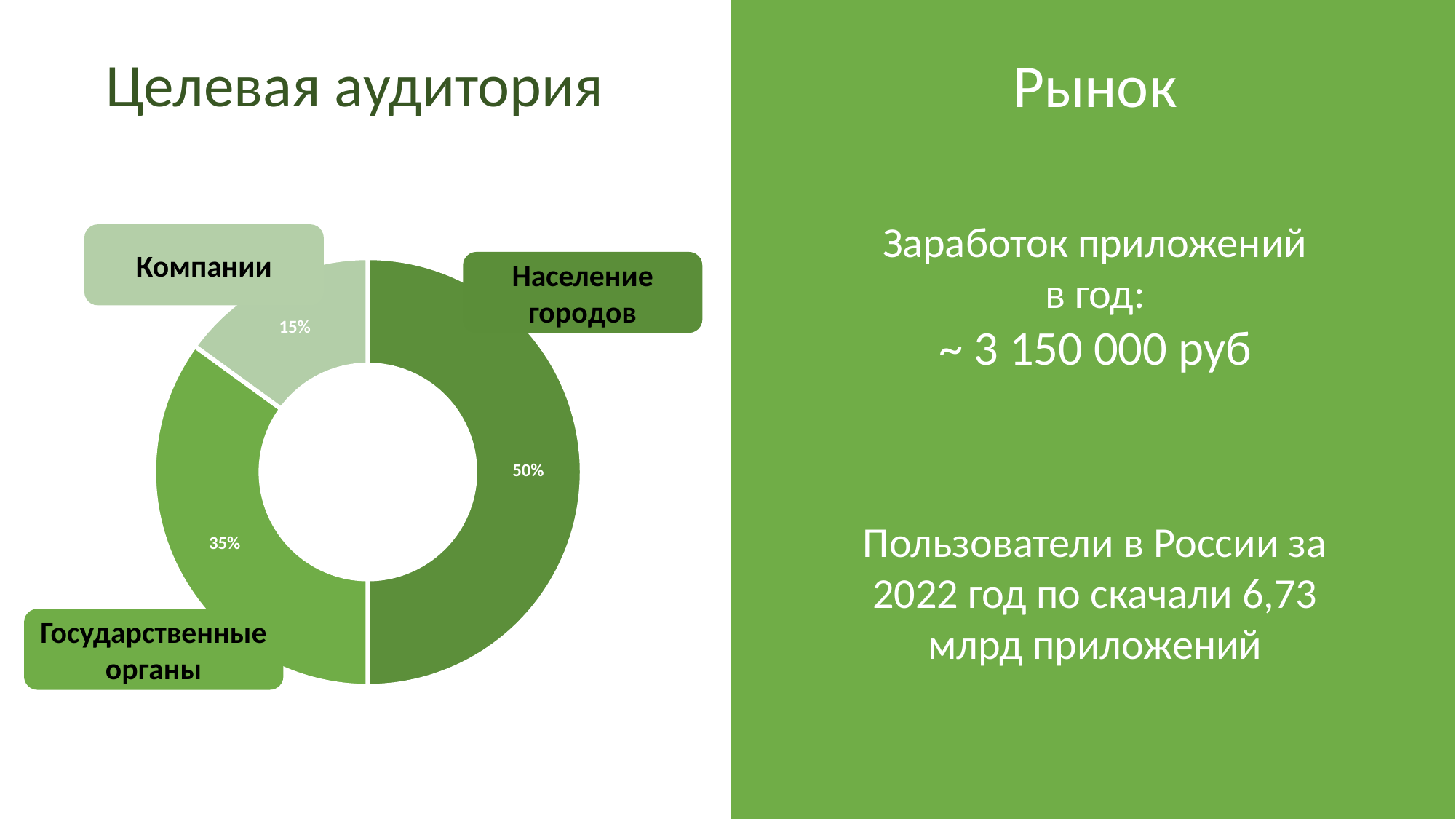
What share of the target audience is Компании? 15% Which is larger: the share for Государственные органы or the share for Компании? Государственные органы What kind of chart is shown on the slide? Doughnut chart What is the difference in percentage points between Государственные органы and Компании? 20 What share of the target audience is Государственные органы? 35% What share of the target audience is Население городов? 50% What is the title above the chart? Целевая аудитория Which category has the smallest share in the chart? Компании Which category is shown in the lightest green colour? Компании What is the difference in percentage points between Население городов and Государственные органы? 15 How many categories does the chart show? 3 Which category has the largest share in the chart? Население городов